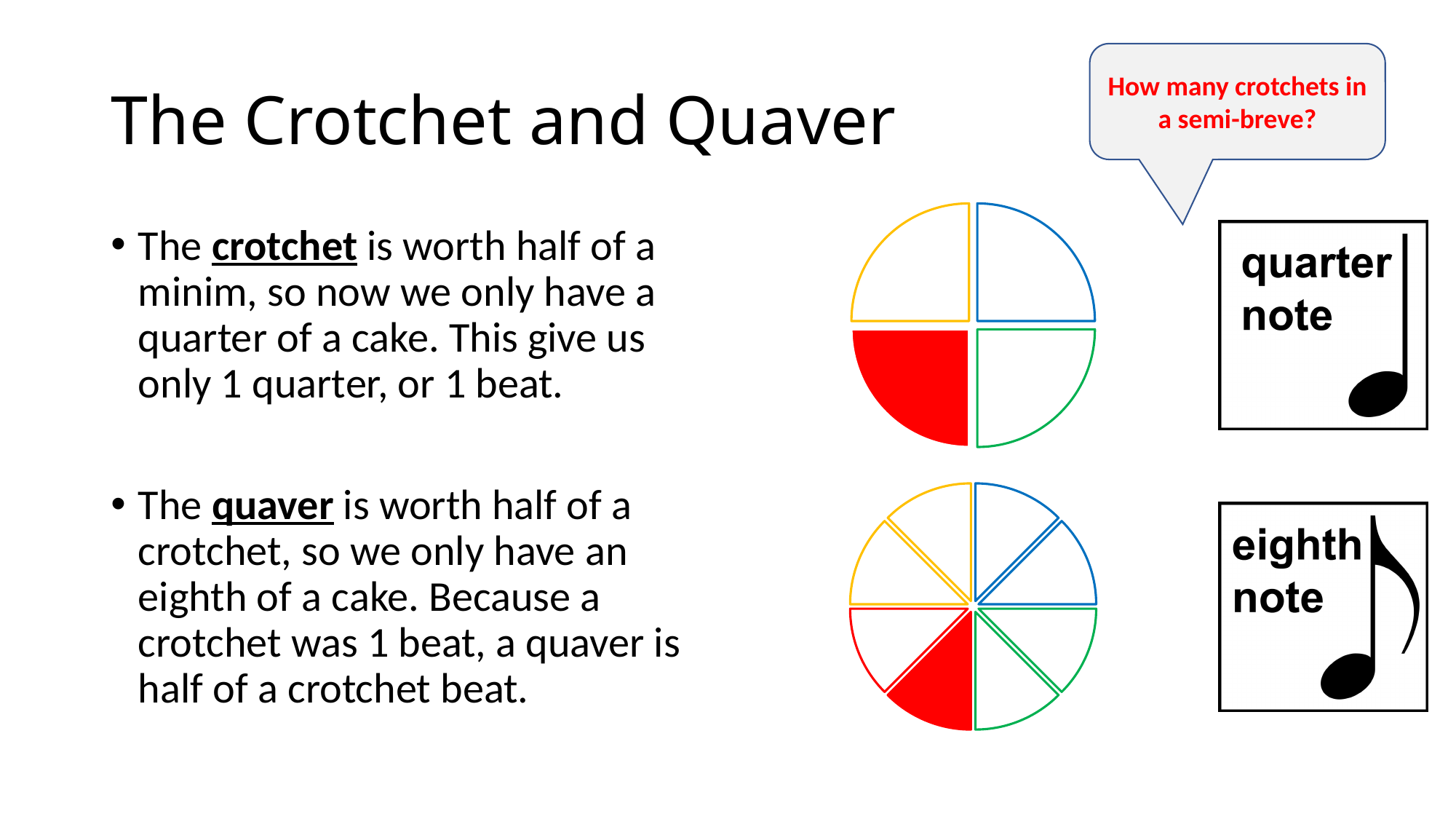
How many equal slices is the bottom circle on the right divided into? 8 In the top circle, what share of the whole does the red shaded slice represent? 1 quarter How many slices are shaded red in the bottom circle? 1 Which circle on the right has more slices, the top one or the bottom one? the bottom one What colour is the filled slice in each circle diagram? red How many equal slices is the top circle on the right divided into? 4 Which note name is shown in the box next to the top circle? quarter note What kind of chart is the top circle diagram on the right of the slide? pie chart In the bottom circle, what share of the whole does the red shaded slice represent? an eighth